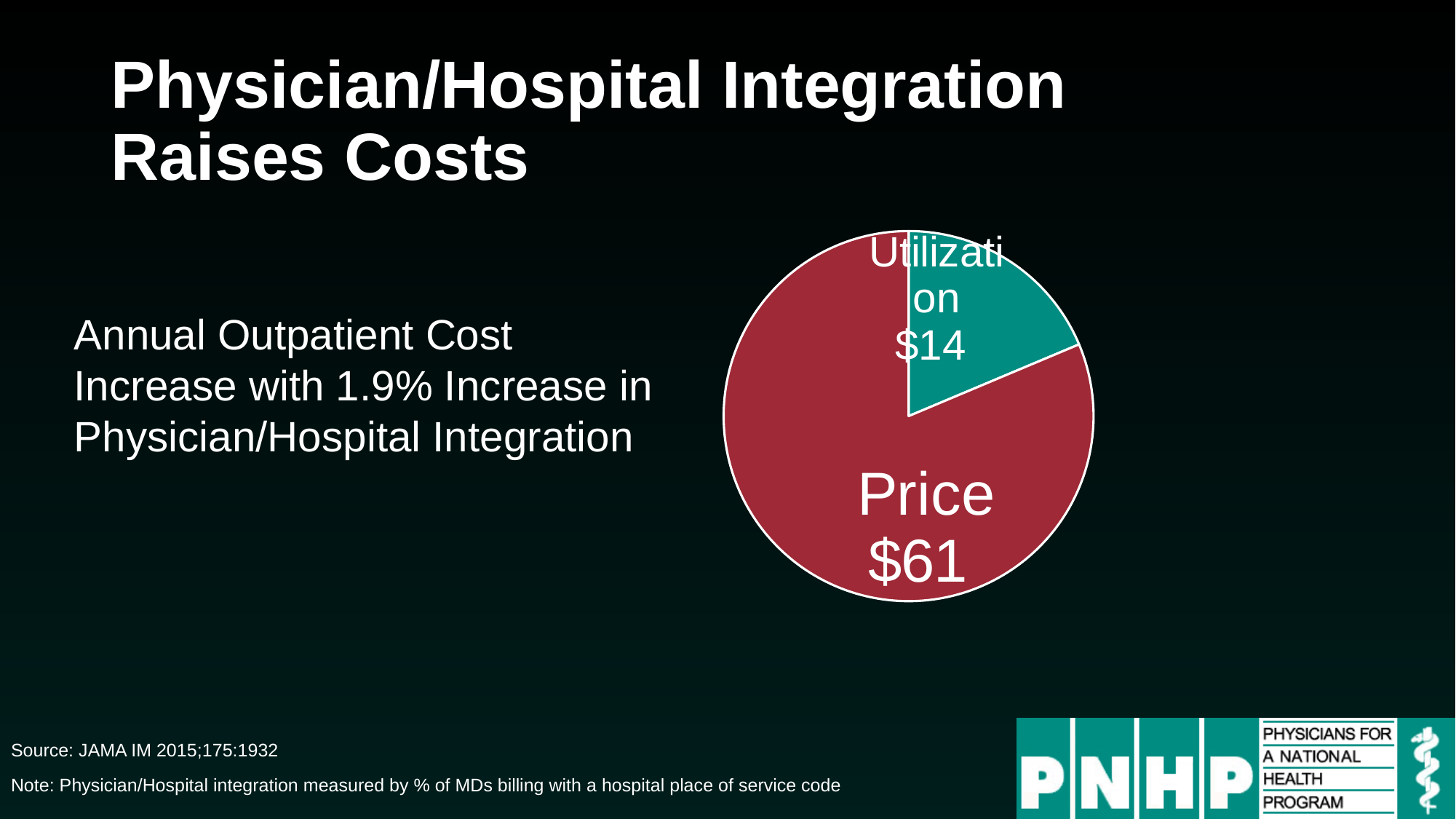
What is the value of the Utilization slice in the pie chart? $14 What type of chart is shown on the slide? pie chart Which slice of the pie chart is the largest? Price Which is larger in the pie chart, Price or Utilization? Price How many slices does the pie chart have? 2 What share of the pie chart total does the Price slice represent, to the nearest whole percent? 81% What colour is the Utilization slice in the pie chart? teal What is the total of the two slices in the pie chart? $75 What colour is the Price slice in the pie chart? red Which slice of the pie chart is the smallest? Utilization What is the difference between the Price and Utilization values in the pie chart? $47 What is the value of the Price slice in the pie chart? $61